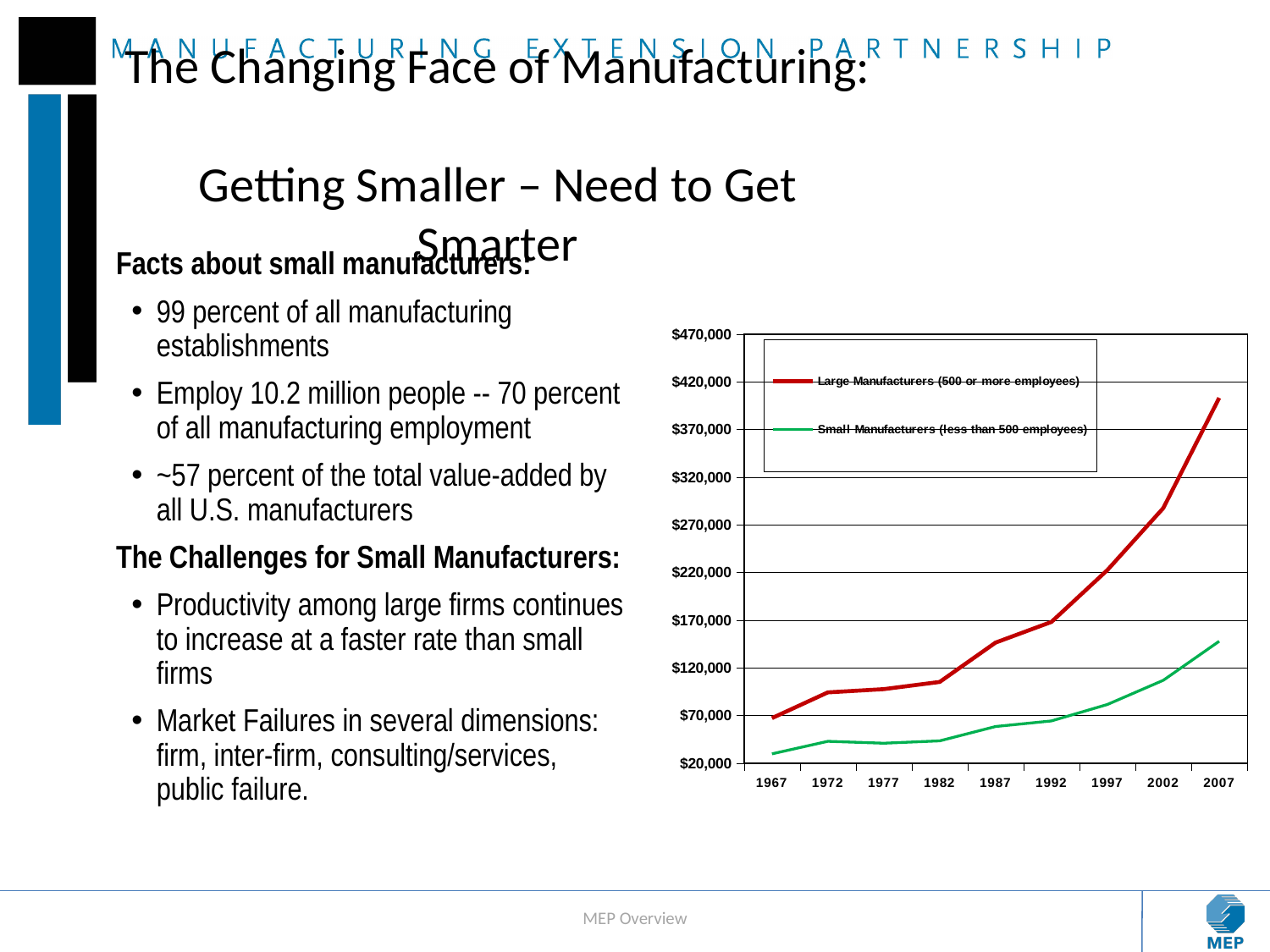
How many series does the chart's legend list? 2 Is the value for Large Manufacturers in 1992 greater or less than $220,000? less Is the value for Small Manufacturers in 1967 greater or less than $70,000? less Which series is drawn in red on the chart? Large Manufacturers (500 or more employees) Which series is drawn in green on the chart? Small Manufacturers (less than 500 employees) What kind of chart is shown on the slide? line chart Does the Large Manufacturers line rise or fall from 1967 to 2007? rise Is the value for Small Manufacturers in 2007 greater or less than $120,000? greater In 2007, which series has the higher value, Large Manufacturers or Small Manufacturers? Large Manufacturers How many years are labelled along the x axis of the chart? 9